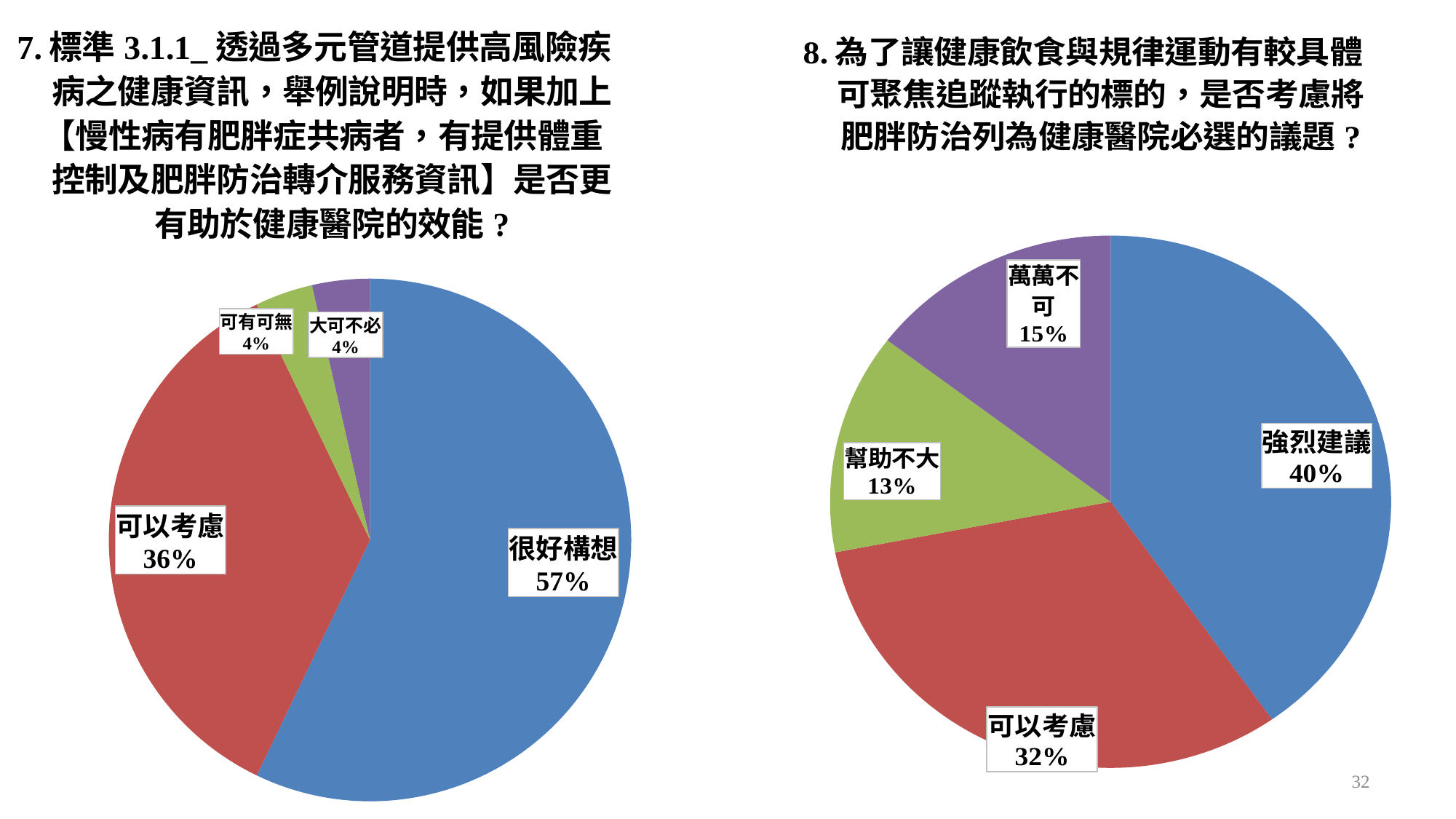
In the right pie chart (question 8), what is the difference between the 強烈建議 and 可以考慮 shares? 8% In the right pie chart (question 8), what share is labelled 萬萬不可? 15% In the left pie chart (question 7), what share is labelled 很好構想? 57% In the left pie chart (question 7), which category has the largest slice? 很好構想 In the left pie chart (question 7), what share is labelled 可以考慮? 36% In the right pie chart (question 8), what colour is the 幫助不大 slice? Green In the right pie chart (question 8), which category has the smallest slice? 幫助不大 What kind of chart is shown on the left side of the slide (question 7)? Pie chart In the left pie chart (question 7), what is the difference between the 很好構想 and 可以考慮 shares? 21% In the left pie chart (question 7), how many slices does the pie have? 4 In the right pie chart (question 8), what share is labelled 強烈建議? 40% In the right pie chart (question 8), which is larger, 可以考慮 or 萬萬不可? 可以考慮